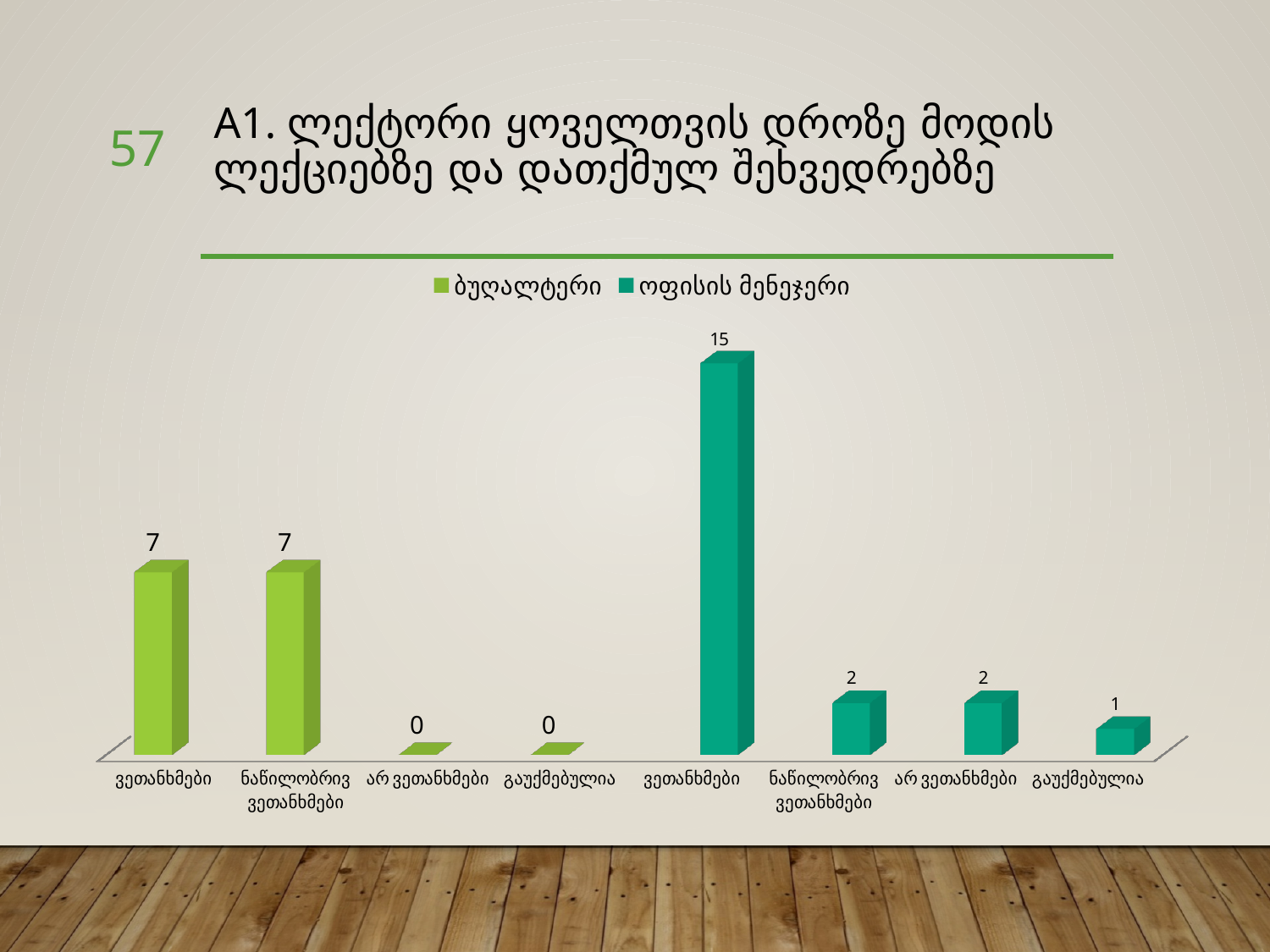
What is the value for ვეთანხმები in the ბუღალტერი series? 7 What is the difference between the ოფისის მენეჯერი value and the ბუღალტერი value for ვეთანხმები? 8 What kind of chart is shown on the slide? Bar chart Which is larger: the ბუღალტერი value for ნაწილობრივ ვეთანხმები or the ოფისის მენეჯერი value for ნაწილობრივ ვეთანხმები? ბუღალტერი Which category has the highest value in the ოფისის მენეჯერი series? ვეთანხმები Which category has the lowest value in the ოფისის მენეჯერი series? გაუქმებულია Which series is shown in teal in the legend? ოფისის მენეჯერი What is the value for არ ვეთანხმები in the ბუღალტერი series? 0 How many series does the legend list? 2 What is the value for ვეთანხმები in the ოფისის მენეჯერი series? 15 How many categories are shown for each series? 4 What is the value for გაუქმებულია in the ოფისის მენეჯერი series? 1